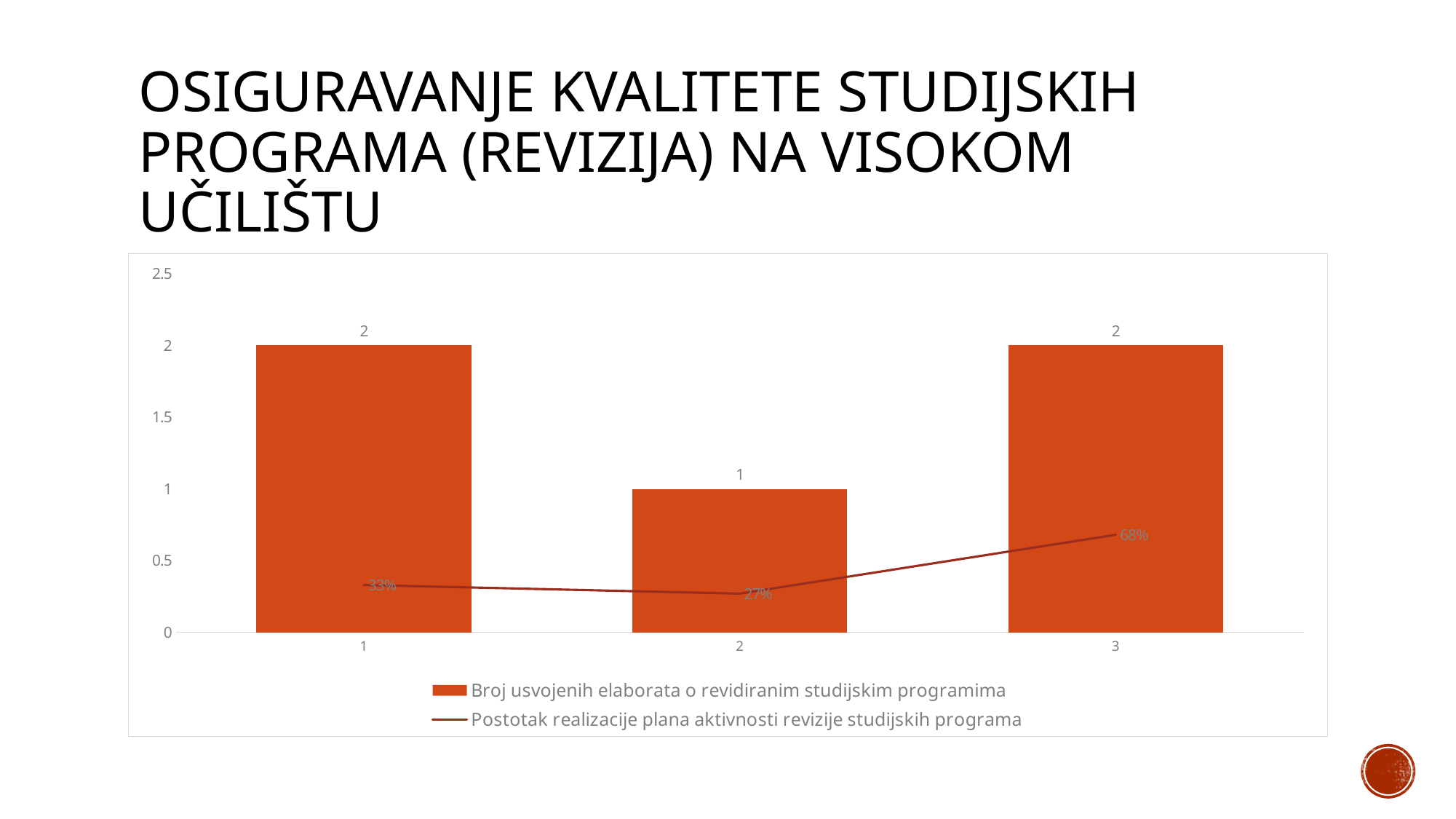
How many categories are shown on the x axis? 3 Which is larger: the 'Postotak realizacije plana aktivnosti revizije studijskih programa' value for category 1 or for category 2? category 1 What is the value of 'Broj usvojenih elaborata o revidiranim studijskim programima' for category 2? 1 What is the value of 'Postotak realizacije plana aktivnosti revizije studijskih programa' for category 3? 68% Which category has the highest value for 'Postotak realizacije plana aktivnosti revizije studijskih programa'? 3 What kind of chart is shown on the slide? combined bar and line chart Which category has the lowest value for 'Broj usvojenih elaborata o revidiranim studijskim programima'? 2 What is the value of 'Postotak realizacije plana aktivnosti revizije studijskih programa' for category 1? 33% What is the value of 'Broj usvojenih elaborata o revidiranim studijskim programima' for category 1? 2 How many series does the legend list? 2 What is the difference between the 'Postotak realizacije plana aktivnosti revizije studijskih programa' values for category 3 and category 2? 41% What colour are the bars for 'Broj usvojenih elaborata o revidiranim studijskim programima'? orange